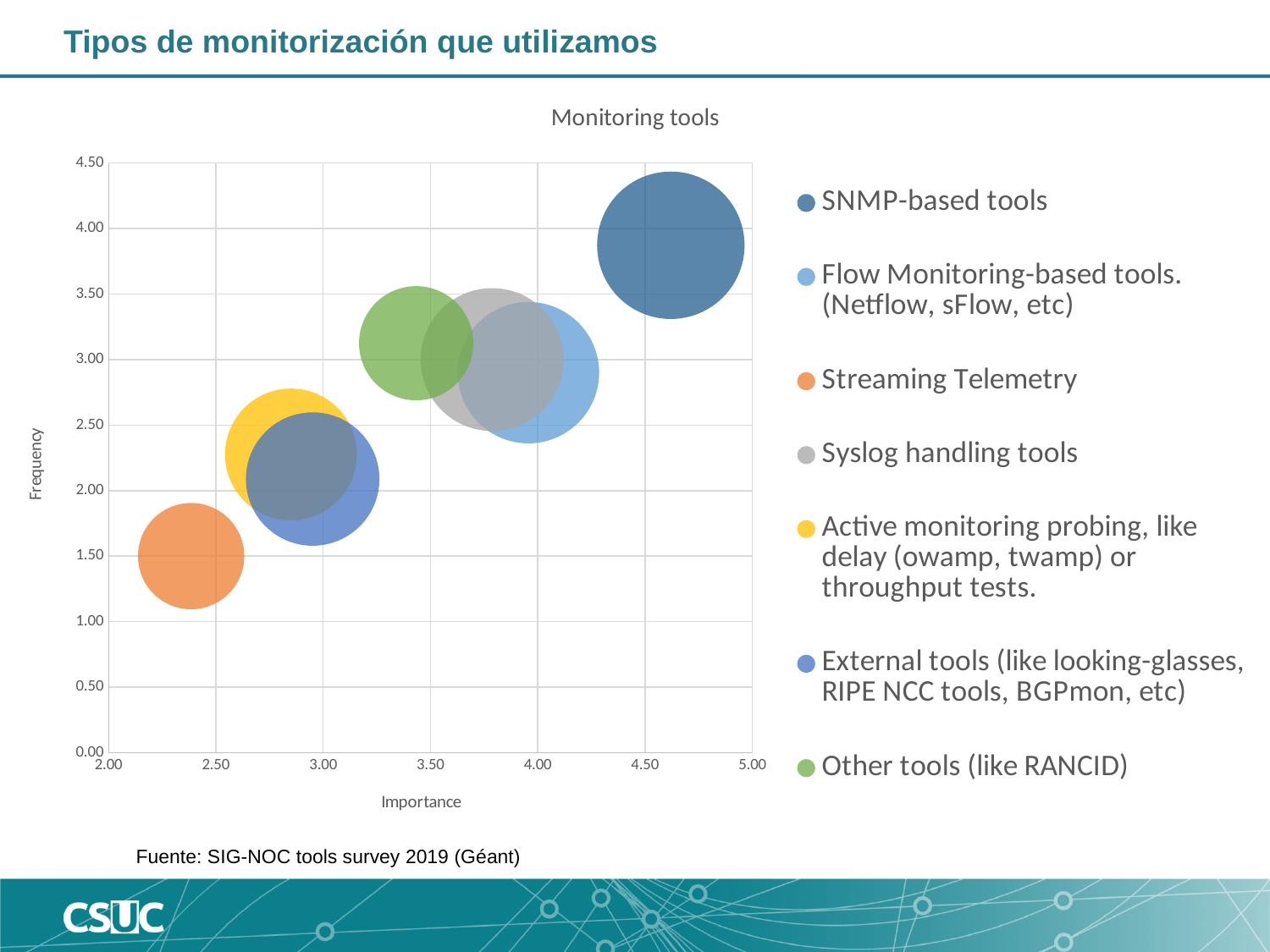
Is the Frequency value for Active monitoring probing greater or less than 2.00? greater Which tool type has the lowest Frequency in the Monitoring tools chart? Streaming Telemetry Which has a higher Importance: Flow Monitoring-based tools or Other tools (like RANCID)? Flow Monitoring-based tools Which tool type has the lowest Importance in the Monitoring tools chart? Streaming Telemetry Which tool type has the highest Importance in the Monitoring tools chart? SNMP-based tools How many series does the legend of the Monitoring tools chart list? 7 What kind of chart is shown on the slide? bubble chart What is the title of the chart on the slide? Monitoring tools How many bubbles are plotted in the Monitoring tools chart? 7 Is the Importance value for Streaming Telemetry greater or less than 2.50? less Which tool type has the highest Frequency in the Monitoring tools chart? SNMP-based tools Is the Frequency value for SNMP-based tools greater or less than 3.50? greater